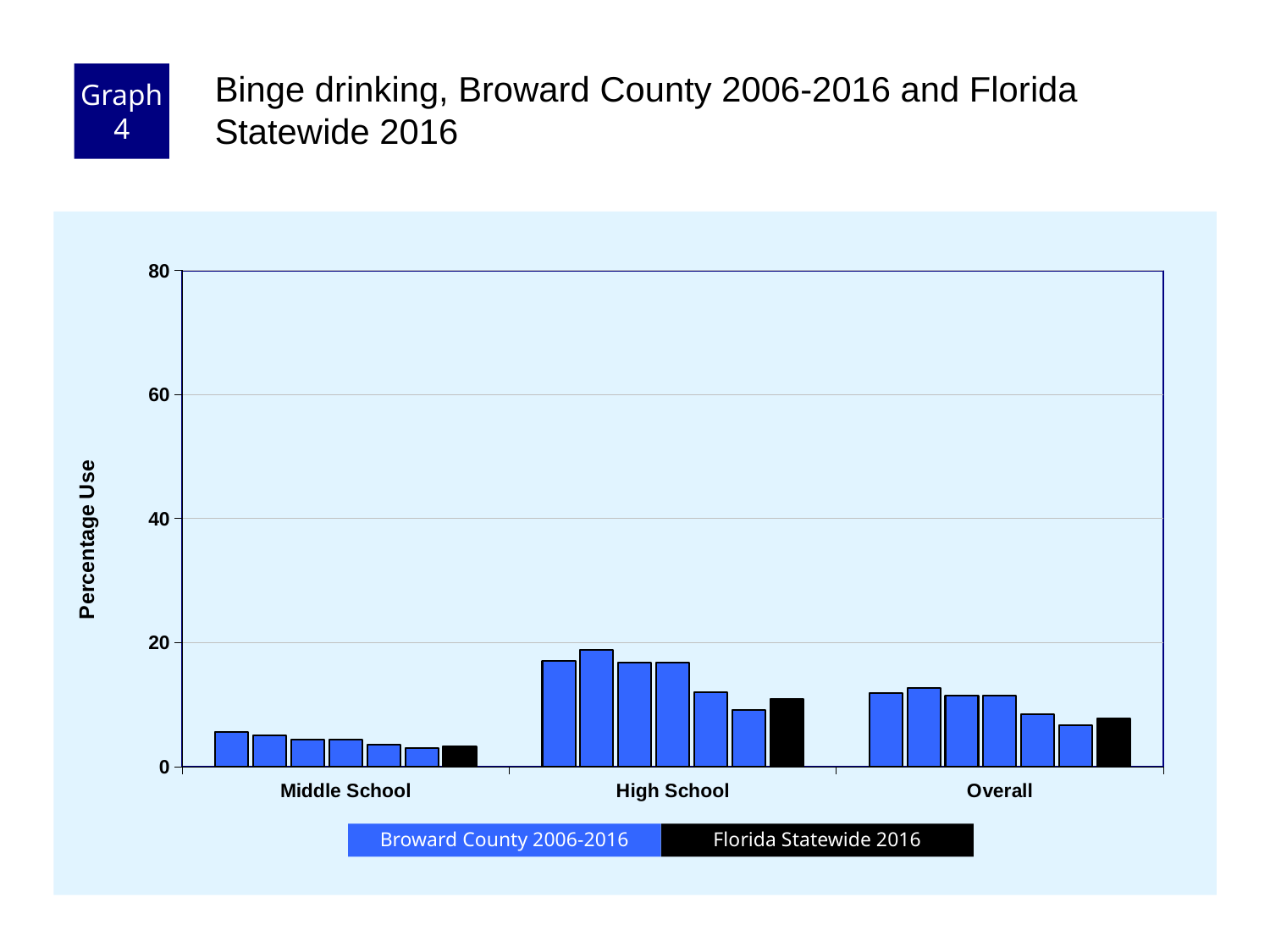
Is the Florida Statewide 2016 value for Overall greater or less than 20? less Is the Florida Statewide 2016 value for High School greater or less than 20? less What kind of chart is shown on the slide? bar chart Which is larger, the Florida Statewide 2016 value for High School or for Middle School? High School Do the Broward County 2006-2016 bars for Middle School rise or fall over time? fall What is the label on the y axis? Percentage Use Which category has the highest binge drinking percentages? High School Are the Middle School values for Broward County 2006-2016 greater or less than 20? less Which category has the lowest binge drinking percentages? Middle School Do the Broward County 2006-2016 bars for High School rise or fall over time? fall How many school-level categories are shown on the x axis? 3 How many series does the legend list? 2